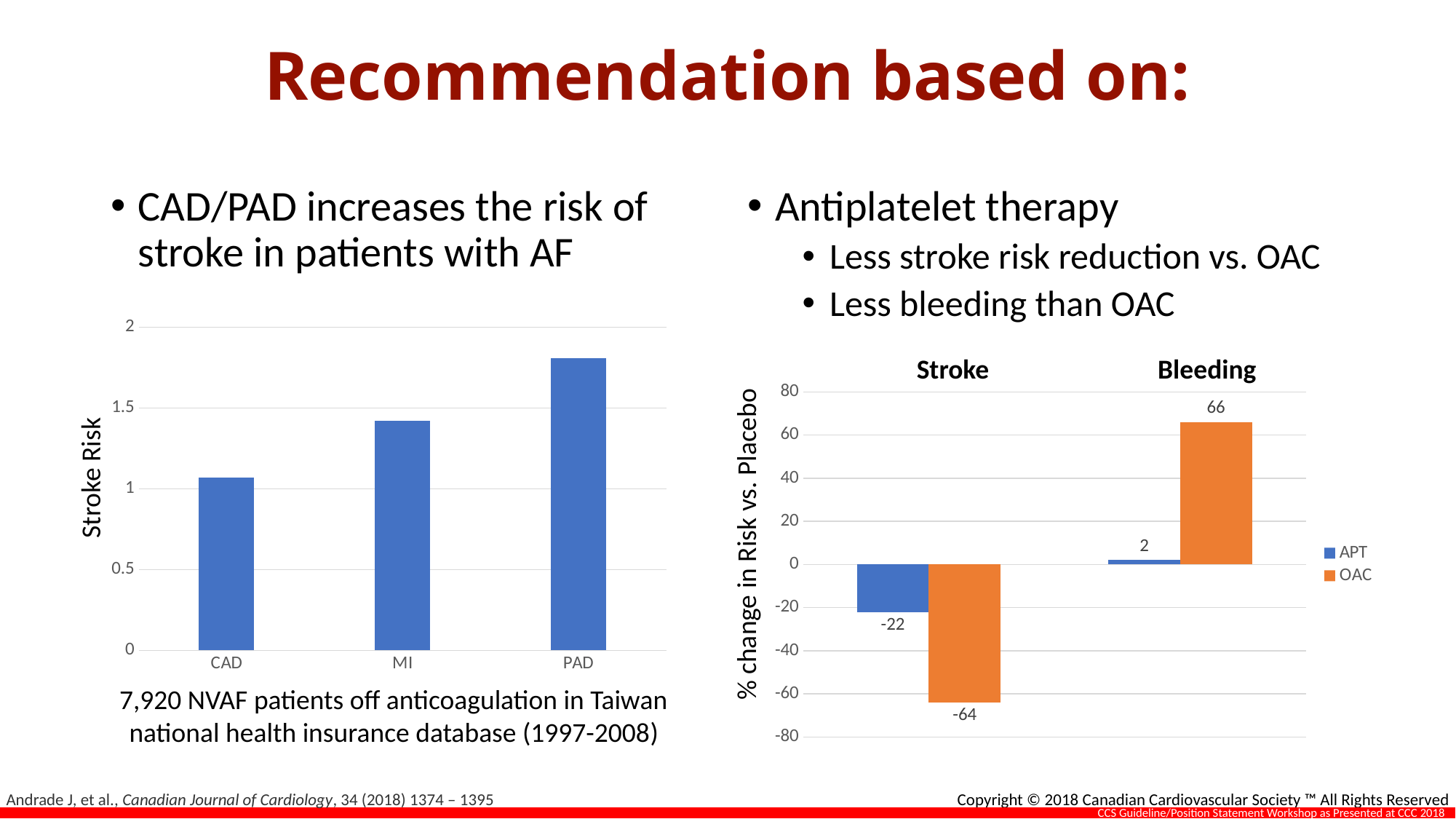
In the left chart (Stroke Risk), which category has the highest stroke risk? PAD In the left chart (Stroke Risk), how many categories are shown on the x axis? 3 What kind of chart is the left chart (Stroke Risk)? bar chart In the right chart (% change in Risk vs. Placebo), what is the value for APT in the Bleeding category? 2 In the left chart (Stroke Risk), which category has the lowest stroke risk? CAD In the left chart (Stroke Risk), is the value for PAD greater or less than 1.5? greater In the right chart (% change in Risk vs. Placebo), what is the value for OAC in the Bleeding category? 66 In the right chart (% change in Risk vs. Placebo), what is the value for APT in the Stroke category? -22 In the right chart (% change in Risk vs. Placebo), what is the difference between the OAC and APT values in the Bleeding category? 64 In the right chart (% change in Risk vs. Placebo), which series has the larger value in the Bleeding category, APT or OAC? OAC In the right chart (% change in Risk vs. Placebo), what is the value for OAC in the Stroke category? -64 In the right chart (% change in Risk vs. Placebo), how many series does the legend list? 2